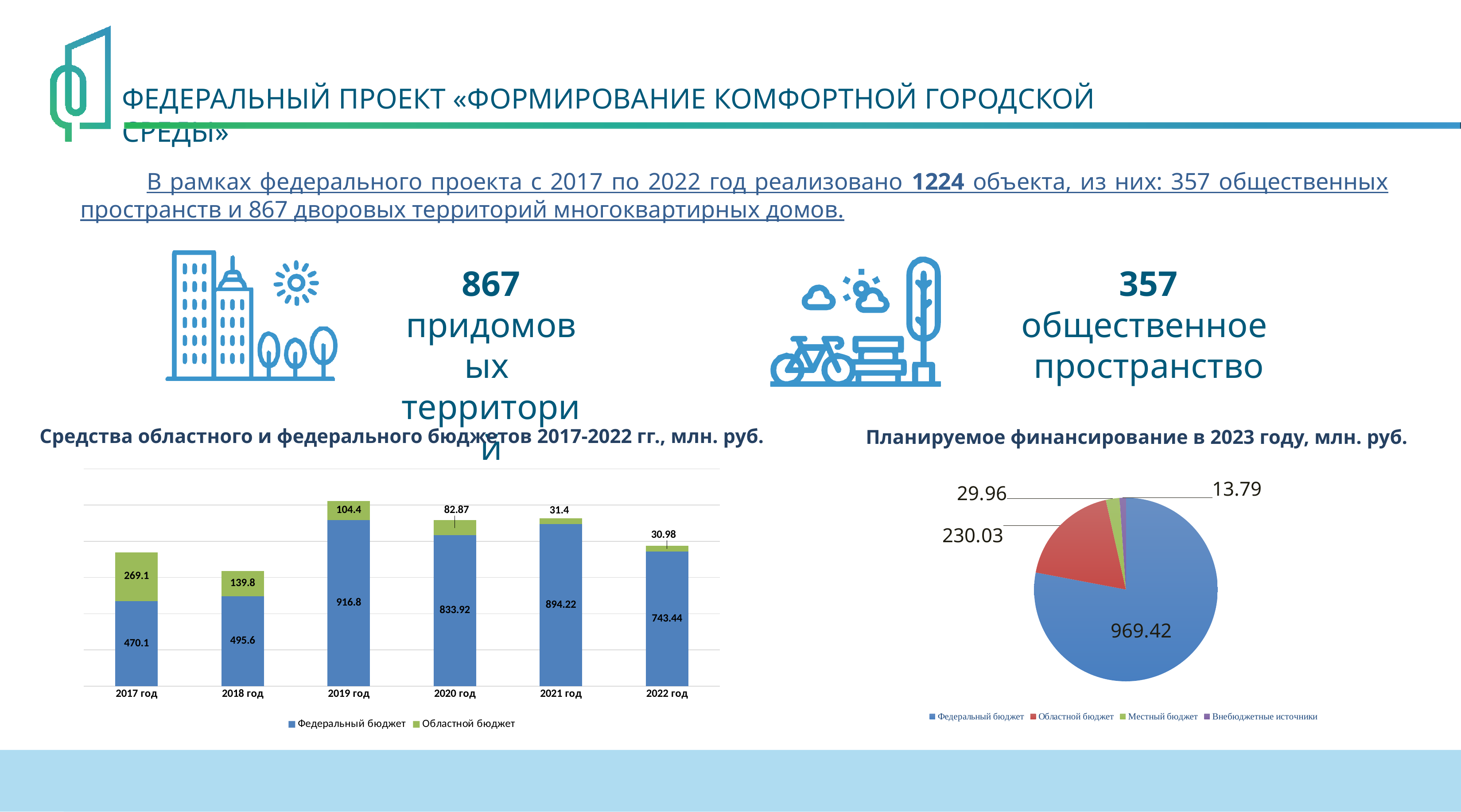
In the bar chart 'Средства областного и федерального бюджетов 2017-2022 гг., млн. руб.', which year has the highest Федеральный бюджет value? 2019 год In the bar chart 'Средства областного и федерального бюджетов 2017-2022 гг., млн. руб.', which year has the lowest Областной бюджет value? 2022 год In the bar chart 'Средства областного и федерального бюджетов 2017-2022 гг., млн. руб.', does the Областной бюджет value rise or fall from 2017 to 2022? fall In the bar chart 'Средства областного и федерального бюджетов 2017-2022 гг., млн. руб.', what is the total of the stacked bar for 2017 год? 739.2 In the pie chart 'Планируемое финансирование в 2023 году, млн. руб.', what is the value for Федеральный бюджет? 969.42 In the pie chart 'Планируемое финансирование в 2023 году, млн. руб.', what is the value for Областной бюджет? 230.03 What kind of chart is the chart on the right of the slide, 'Планируемое финансирование в 2023 году, млн. руб.'? pie chart In the bar chart 'Средства областного и федерального бюджетов 2017-2022 гг., млн. руб.', how many years are shown on the x axis? 6 In the bar chart 'Средства областного и федерального бюджетов 2017-2022 гг., млн. руб.', what is the value of Федеральный бюджет for 2019 год? 916.8 In the bar chart 'Средства областного и федерального бюджетов 2017-2022 гг., млн. руб.', what is the value of Областной бюджет for 2017 год? 269.1 In the pie chart 'Планируемое финансирование в 2023 году, млн. руб.', how many series does the legend list? 4 In the bar chart 'Средства областного и федерального бюджетов 2017-2022 гг., млн. руб.', what is the difference between the Федеральный бюджет values for 2019 год and 2017 год? 446.7